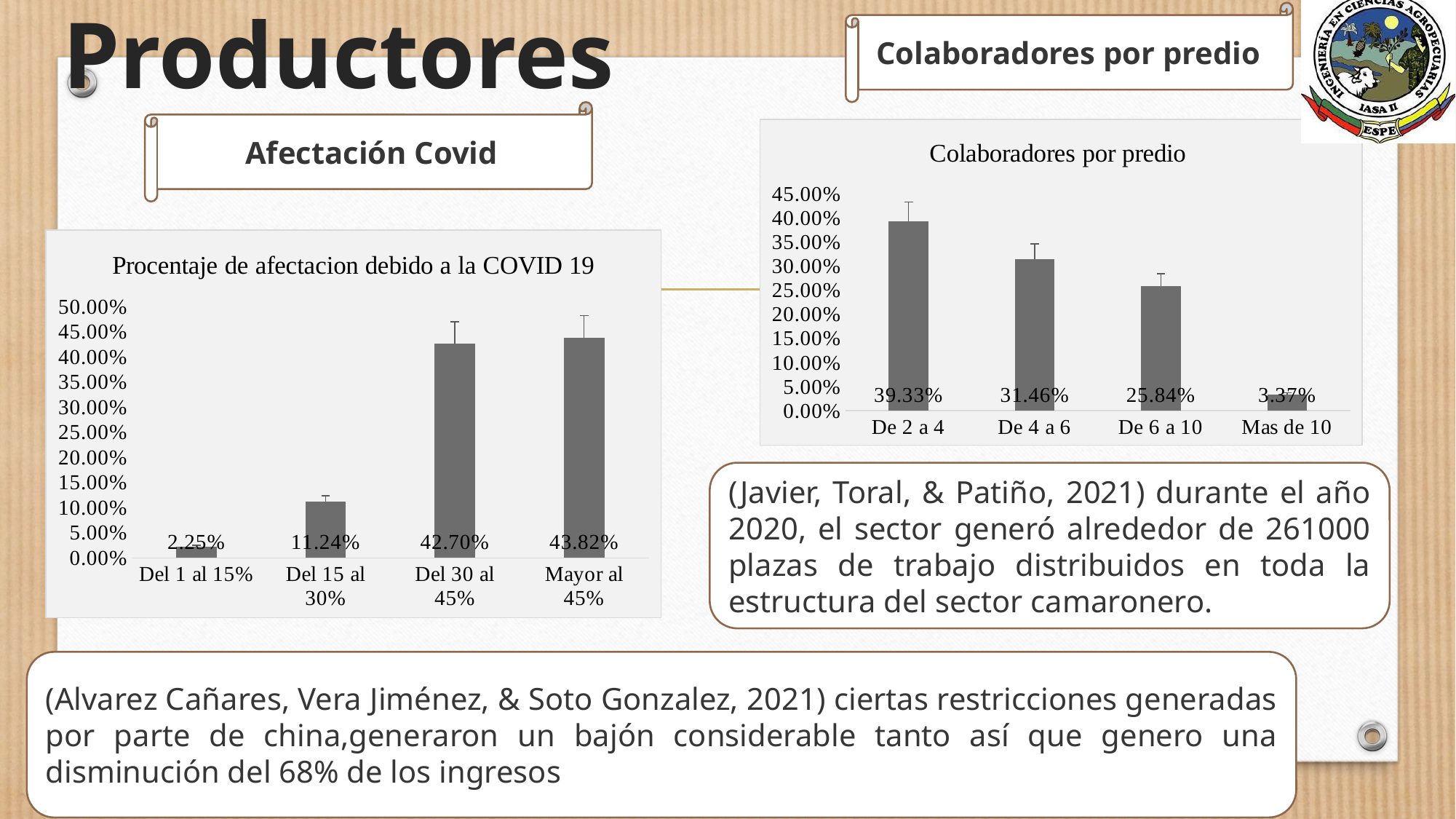
In the chart titled 'Procentaje de afectacion debido a la COVID 19', which category has the highest value? Mayor al 45% In the chart titled 'Procentaje de afectacion debido a la COVID 19', what is the value for 'Del 15 al 30%'? 11.24% In the chart titled 'Procentaje de afectacion debido a la COVID 19', how many categories are shown? 4 What kind of chart is the chart titled 'Colaboradores por predio'? bar chart In the chart titled 'Colaboradores por predio', what is the difference between the values for 'De 2 a 4' and 'De 4 a 6'? 7.87% In the chart titled 'Colaboradores por predio', what is the value for 'Mas de 10'? 3.37% In the chart titled 'Colaboradores por predio', what is the value for 'De 6 a 10'? 25.84% In the chart titled 'Procentaje de afectacion debido a la COVID 19', what is the difference between the values for 'Del 30 al 45%' and 'Del 15 al 30%'? 31.46% In the chart titled 'Procentaje de afectacion debido a la COVID 19', what is the value for 'Mayor al 45%'? 43.82% In the chart titled 'Colaboradores por predio', do the values rise or fall from left to right along the x axis? fall In the chart titled 'Procentaje de afectacion debido a la COVID 19', which category has the lowest value? Del 1 al 15% In the chart titled 'Colaboradores por predio', which category has the highest value? De 2 a 4